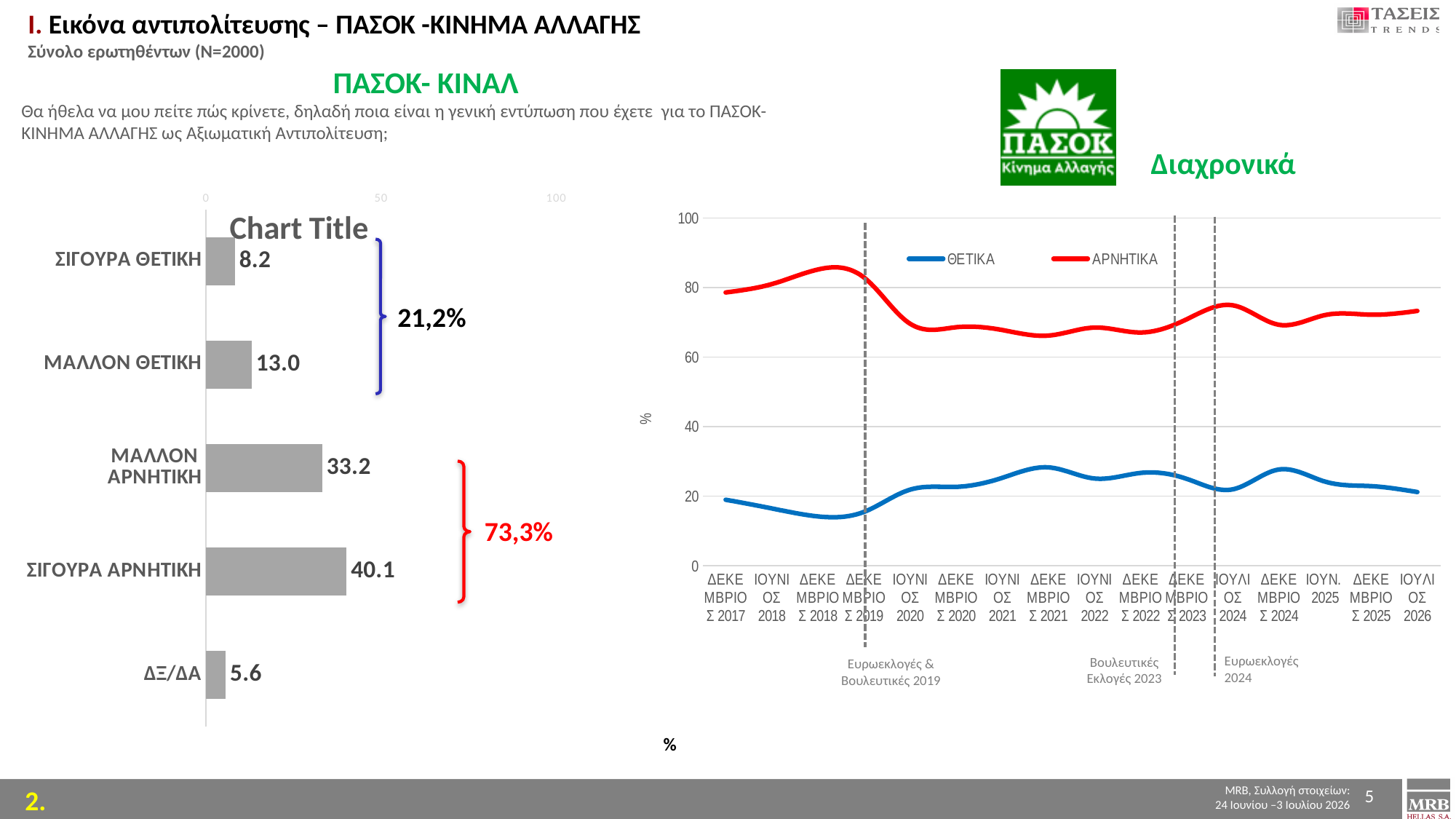
In the bar chart on the left, what is the difference between ΣΙΓΟΥΡΑ ΑΡΝΗΤΙΚΗ and ΜΑΛΛΟΝ ΑΡΝΗΤΙΚΗ? 6.9 How many series does the legend of the line chart titled Διαχρονικά list? 2 What kind of chart is the chart on the left of the slide? bar chart In the line chart titled Διαχρονικά, which series is higher at ΙΟΥΛΙΟΣ 2026: ΘΕΤΙΚΑ or ΑΡΝΗΤΙΚΑ? ΑΡΝΗΤΙΚΑ How many categories does the bar chart on the left show? 5 In the bar chart on the left, which category has the lowest value? ΔΞ/ΔΑ In the line chart titled Διαχρονικά, is the value for ΑΡΝΗΤΙΚΑ at ΔΕΚΕΜΒΡΙΟΣ 2018 greater or less than 80? greater In the bar chart on the left, which category has the highest value? ΣΙΓΟΥΡΑ ΑΡΝΗΤΙΚΗ In the bar chart on the left, which is larger: ΣΙΓΟΥΡΑ ΘΕΤΙΚΗ or ΜΑΛΛΟΝ ΘΕΤΙΚΗ? ΜΑΛΛΟΝ ΘΕΤΙΚΗ In the bar chart on the left, what is the value for ΣΙΓΟΥΡΑ ΑΡΝΗΤΙΚΗ? 40.1 In the bar chart on the left, what is the value for ΔΞ/ΔΑ? 5.6 In the bar chart on the left, what is the value for ΜΑΛΛΟΝ ΘΕΤΙΚΗ? 13.0